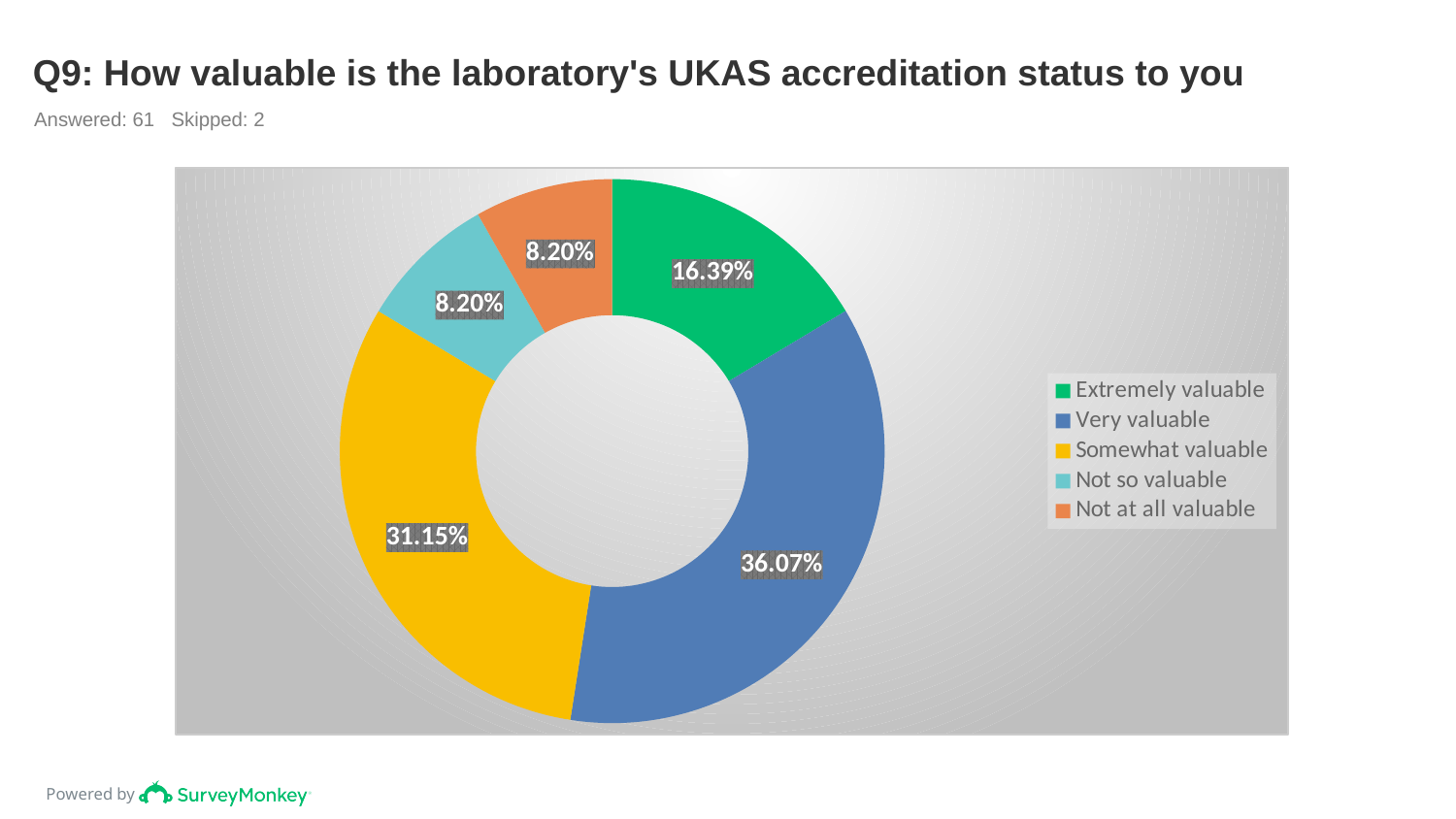
What share of the pie is labelled Somewhat valuable? 31.15% What percentage is shown for Extremely valuable? 16.39% How many entries does the legend list? 5 Which is larger, the share for Somewhat valuable or the share for Extremely valuable? Somewhat valuable What is the difference in percentage points between Extremely valuable and Not so valuable? 8.19 What kind of chart is shown on the slide? Doughnut chart What is the difference in percentage points between Very valuable and Somewhat valuable? 4.92 Which category has the largest share of the pie? Very valuable What percentage is shown for Not at all valuable? 8.20% How many categories does the pie chart show? 5 How many respondents answered this question according to the slide? 61 What percentage of respondents said the UKAS accreditation status is Very valuable? 36.07%